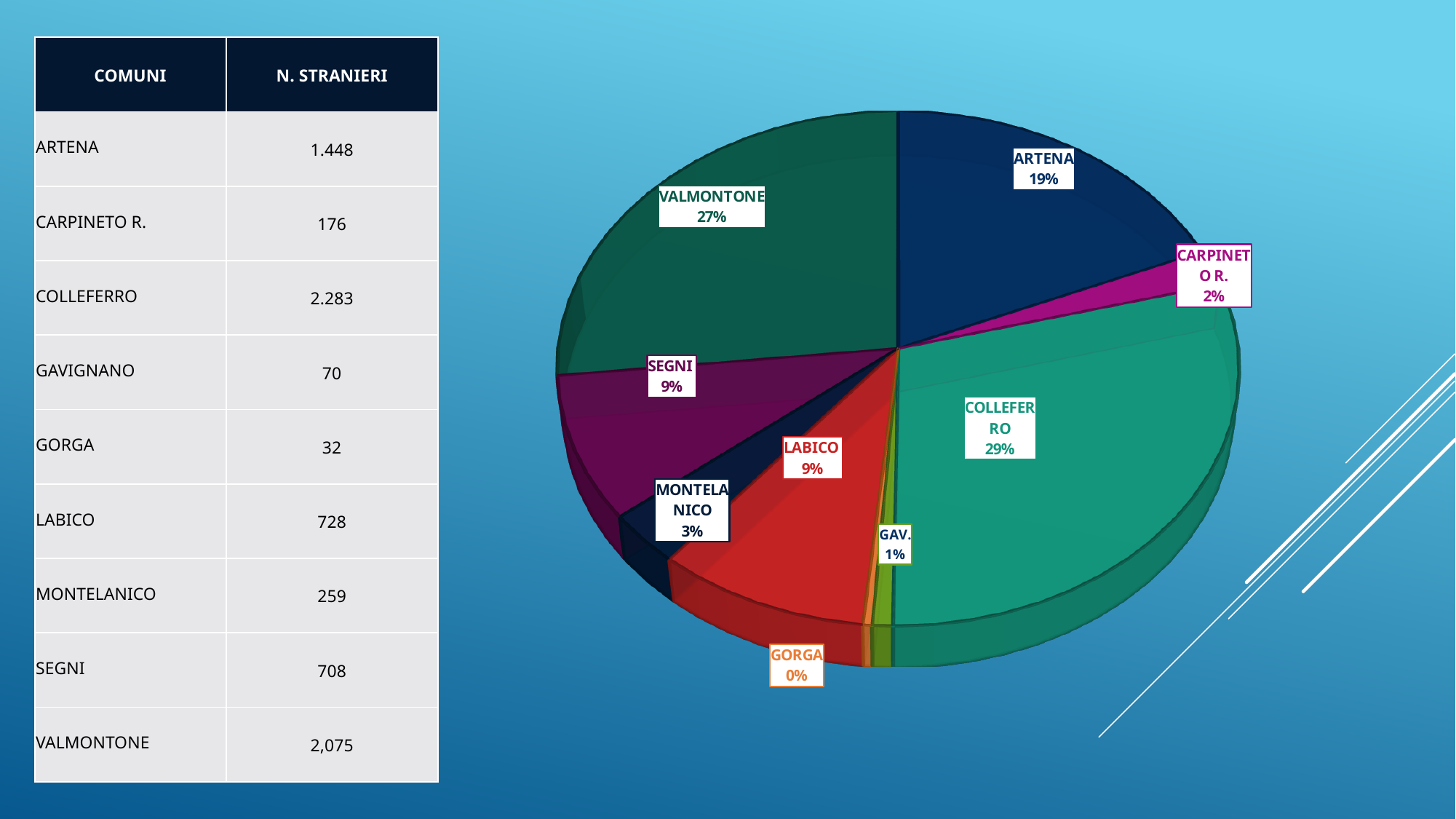
What kind of chart is shown on the slide? pie chart What share of the pie does COLLEFERRO have? 29% Which has a larger share of the pie, ARTENA or VALMONTONE? VALMONTONE What percentage is shown for MONTELANICO in the pie chart? 3% By how many percentage points does COLLEFERRO's share exceed VALMONTONE's share? 2 What share of the pie does VALMONTONE have? 27% How many slices does the pie chart have? 9 What percentage is shown for CARPINETO R. in the pie chart? 2% What percentage is shown for ARTENA in the pie chart? 19% What percentage is shown for GAV. in the pie chart? 1% Which slice of the pie chart is the smallest? GORGA Which slice of the pie chart is the largest? COLLEFERRO